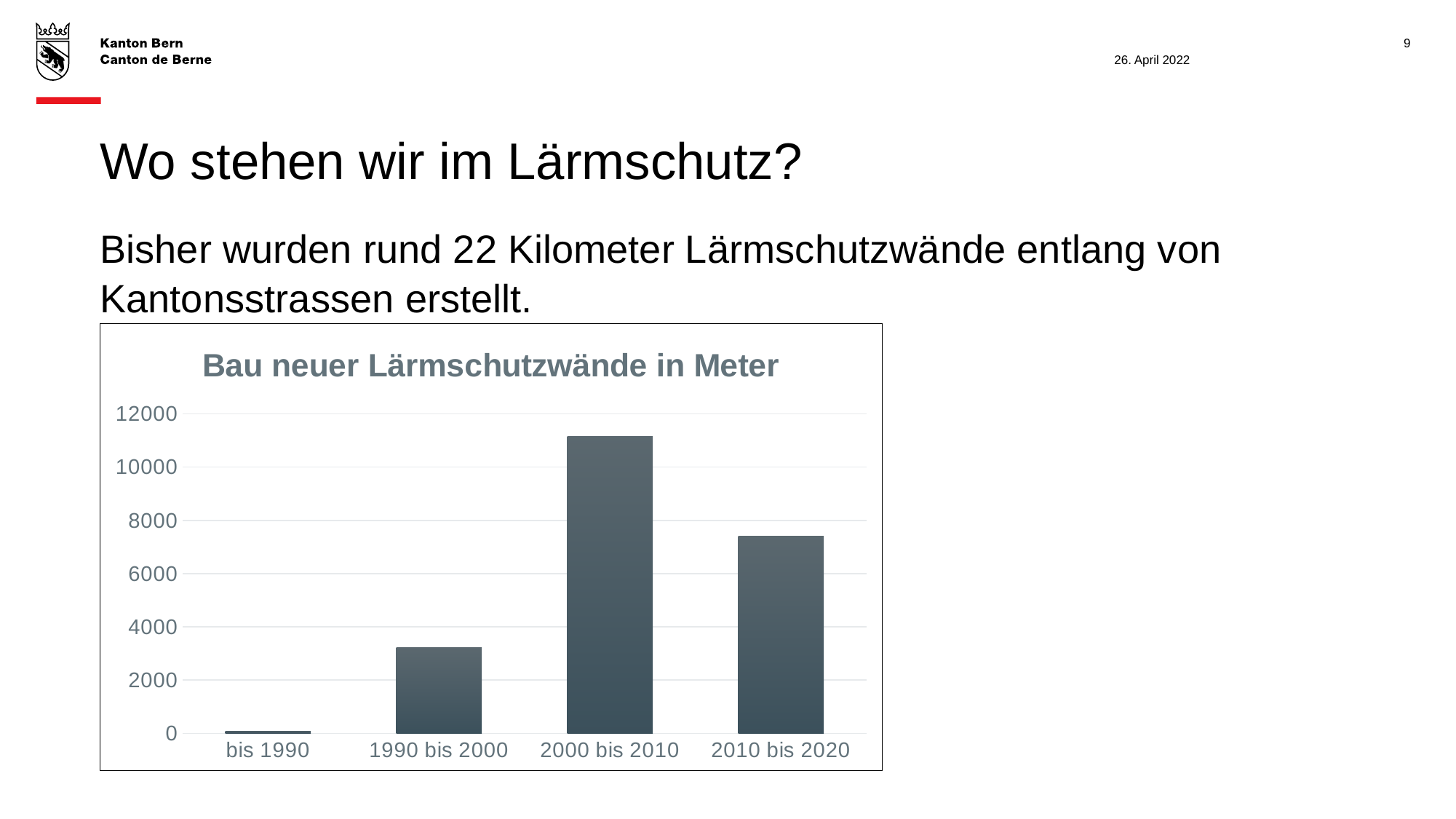
Is the value for 2000 bis 2010 greater or less than 10000? greater What type of chart is shown on the slide? bar chart Is the value for 1990 bis 2000 greater or less than 4000? less Which period has the lowest value in the chart? bis 1990 How many categories are shown on the x axis of the chart? 4 Which period has the highest value in the chart? 2000 bis 2010 What is the highest value shown on the y axis of the chart? 12000 Is the value for 2010 bis 2020 greater or less than 6000? greater Which is larger, the value for 2000 bis 2010 or the value for 2010 bis 2020? 2000 bis 2010 What is the title of the chart? Bau neuer Lärmschutzwände in Meter Which is larger, the value for 1990 bis 2000 or the value for 2010 bis 2020? 2010 bis 2020